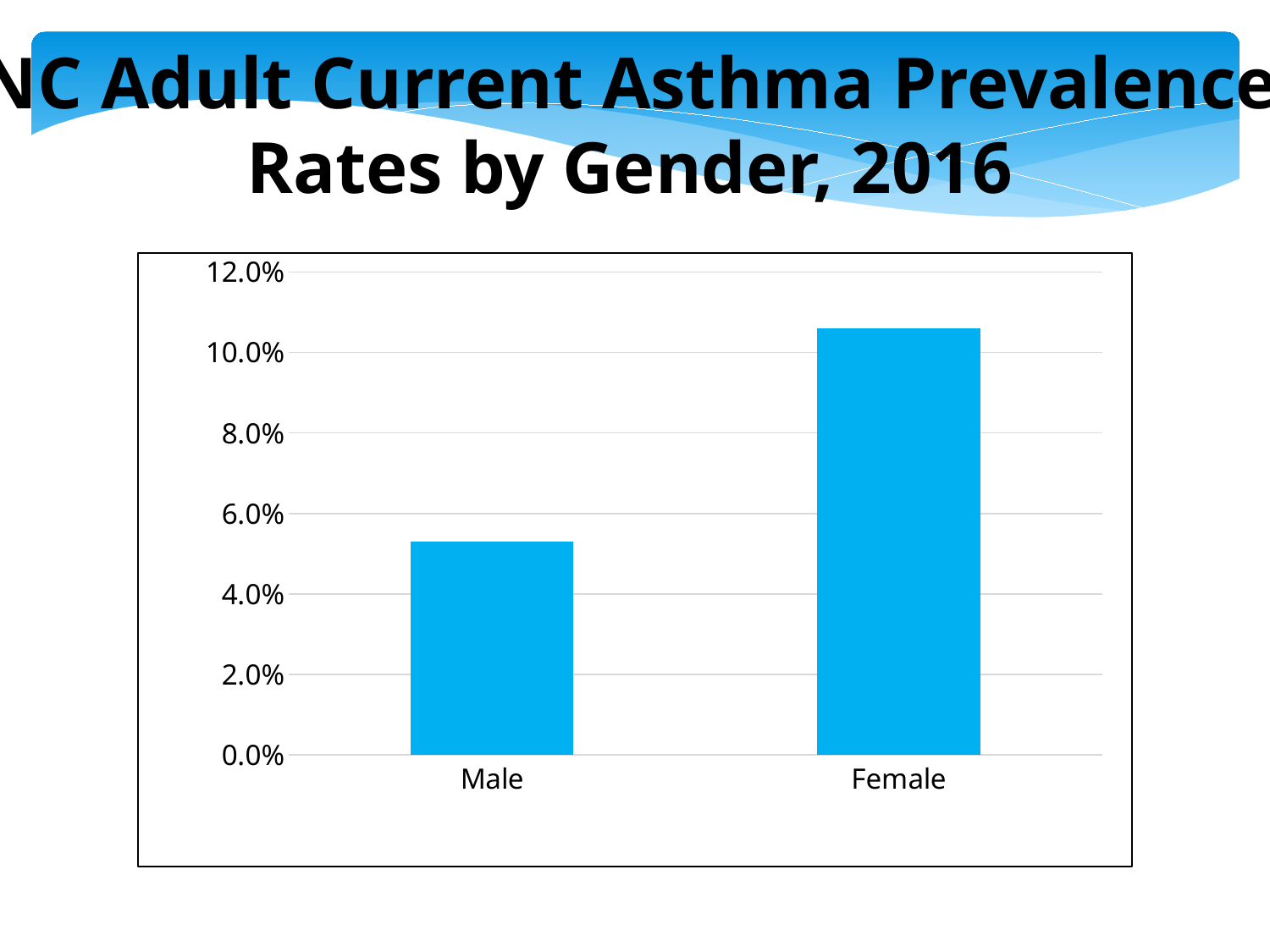
Which category has the highest asthma prevalence rate? Female Is the value for Male greater or less than 6.0%? less What is the title of the slide containing the chart? NC Adult Current Asthma Prevalence Rates by Gender, 2016 What is the highest value shown on the y axis of the chart? 12.0% Which category has the lowest asthma prevalence rate? Male Is the value for Female greater or less than 10.0%? greater Is the value for Male greater or less than 4.0%? greater How many categories are shown on the x axis of the chart? 2 What kind of chart is shown on the slide? bar chart Which is larger, the value for Male or the value for Female? Female